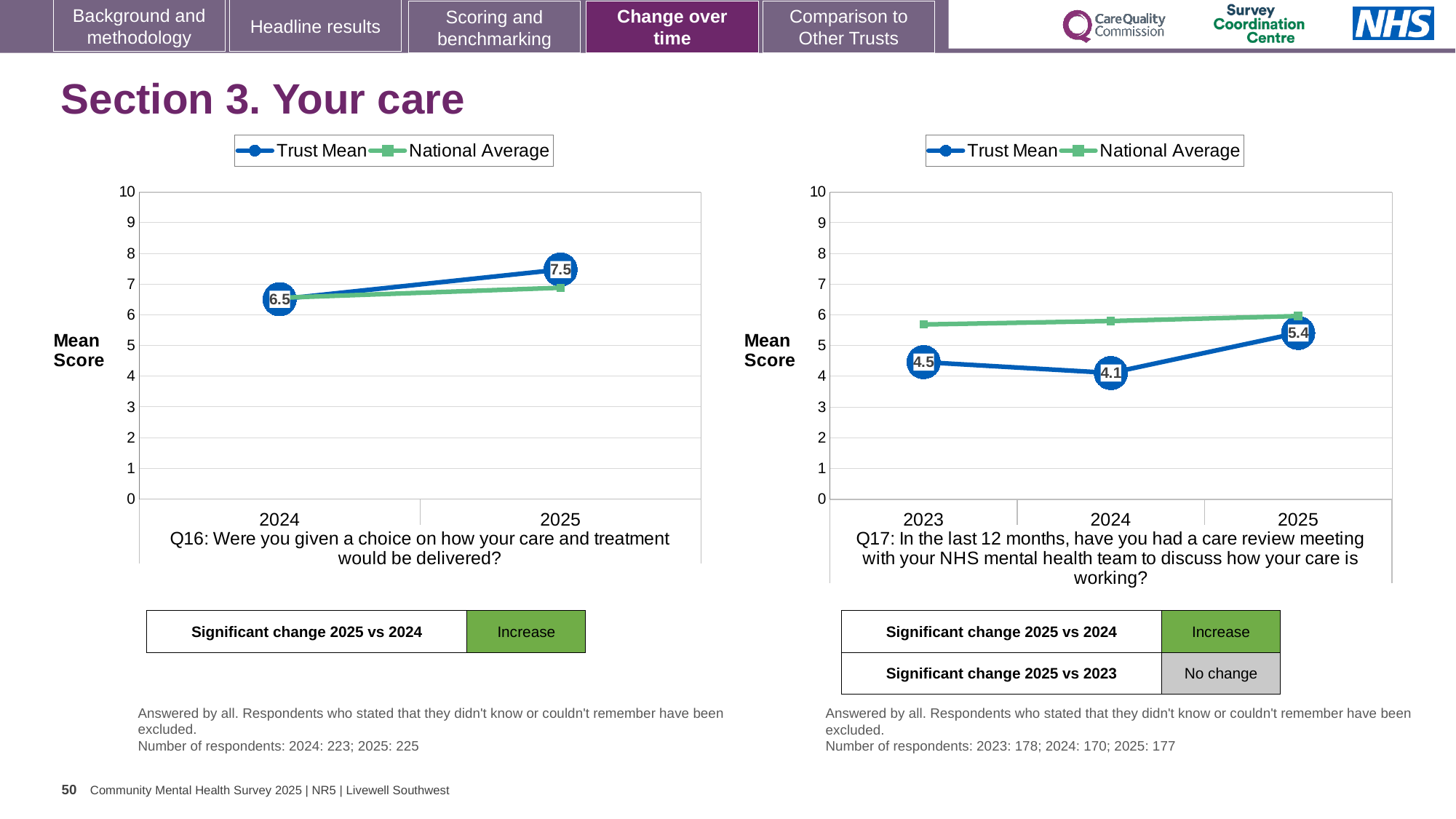
In the right chart (Q17), what is the difference between the Trust Mean in 2025 and in 2023? 0.9 In the right chart (Q17), how many years are plotted on the x axis? 3 In the left chart (Q16), how many series does the legend list? 2 In the right chart (Q17), what is the Trust Mean for 2024? 4.1 In the right chart (Q17), which year has the highest Trust Mean? 2025 In the left chart (Q16), what is the Trust Mean for 2025? 7.5 In the right chart (Q17), what is the Trust Mean for 2025? 5.4 In the right chart (Q17), is the National Average for 2023 greater or less than 5? greater In the left chart (Q16), does the Trust Mean rise or fall from 2024 to 2025? rise In the right chart (Q17), which year has the lowest Trust Mean? 2024 In the left chart (Q16), by how much did the Trust Mean change from 2024 to 2025? 1.0 In the left chart (Q16), what is the Trust Mean for 2024? 6.5